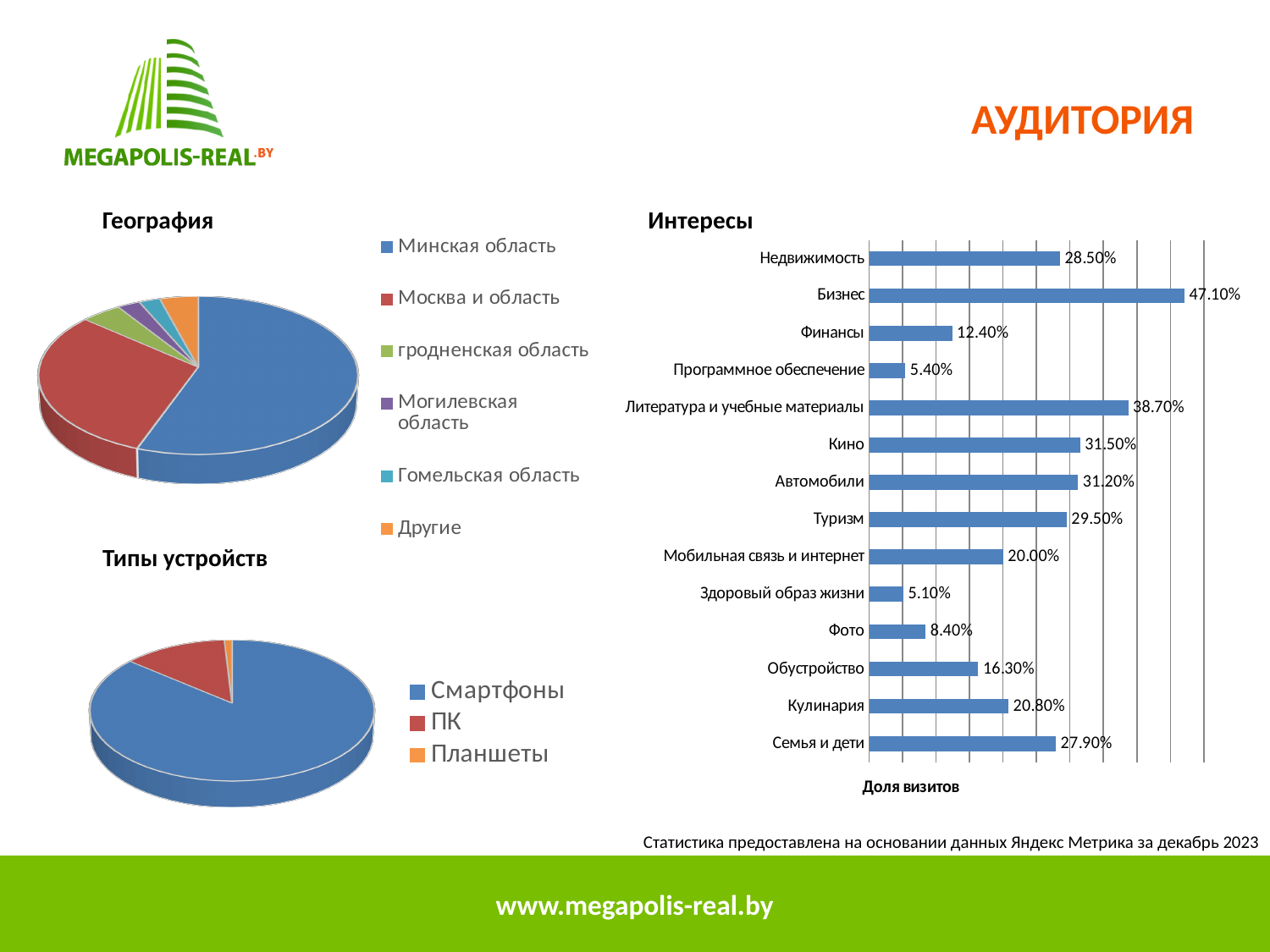
In the 'Интересы' chart, what is the value for Литература и учебные материалы? 38.70% In the 'Интересы' chart, which category has the lowest value? Здоровый образ жизни In the 'Интересы' chart, what is the value for Бизнес? 47.10% What kind of chart is the 'География' chart? pie chart In the 'Интересы' chart, which category has the highest value? Бизнес In the 'Интересы' chart, what is the value for Здоровый образ жизни? 5.10% What kind of chart is the 'Интересы' chart? bar chart In the 'Типы устройств' chart, which category has the largest slice? Смартфоны How many categories are shown in the 'Интересы' chart? 14 How many entries does the legend of the 'География' chart list? 6 In the 'Интересы' chart, what is the difference between the values for Бизнес and Недвижимость? 18.60% In the 'Интересы' chart, which is larger: the value for Туризм or the value for Семья и дети? Туризм